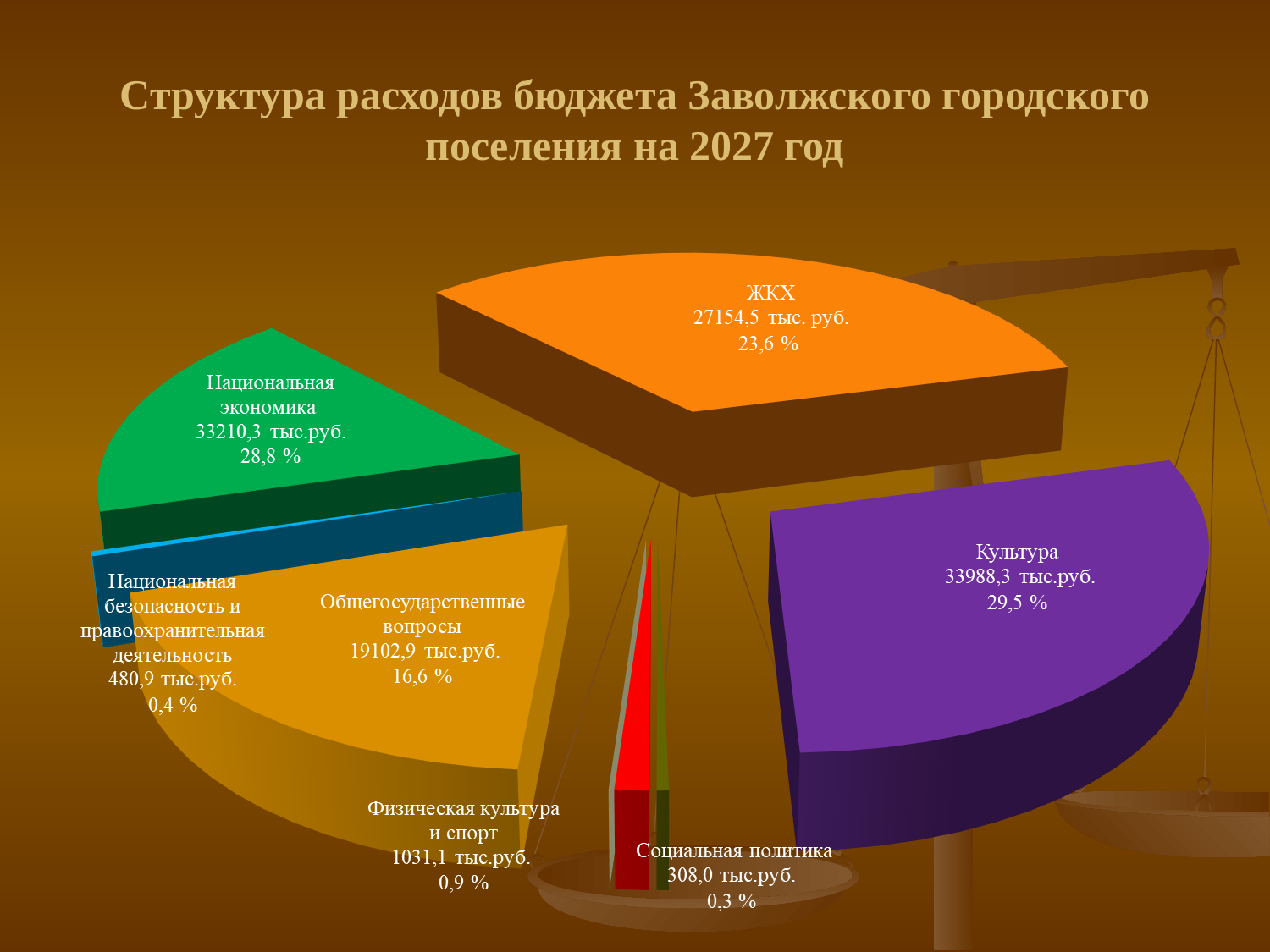
Which category has the largest share of the budget? Культура What percentage is shown for Национальная экономика? 28,8 % What is the difference in percentage points between ЖКХ and Общегосударственные вопросы? 7,0 % Which category has the smallest share of the budget? Социальная политика Which is larger, the value for Культура or the value for Национальная экономика? Культура What is the title of the chart on the slide? Структура расходов бюджета Заволжского городского поселения на 2027 год What share of the pie does Культура represent? 29,5 % What is the difference in тыс.руб. between Культура and Национальная экономика? 778,0 тыс.руб. What is the value for Общегосударственные вопросы? 19102,9 тыс.руб. What kind of chart is shown on the slide? pie chart How many slices does the pie chart have? 7 What is the value for ЖКХ? 27154,5 тыс. руб.